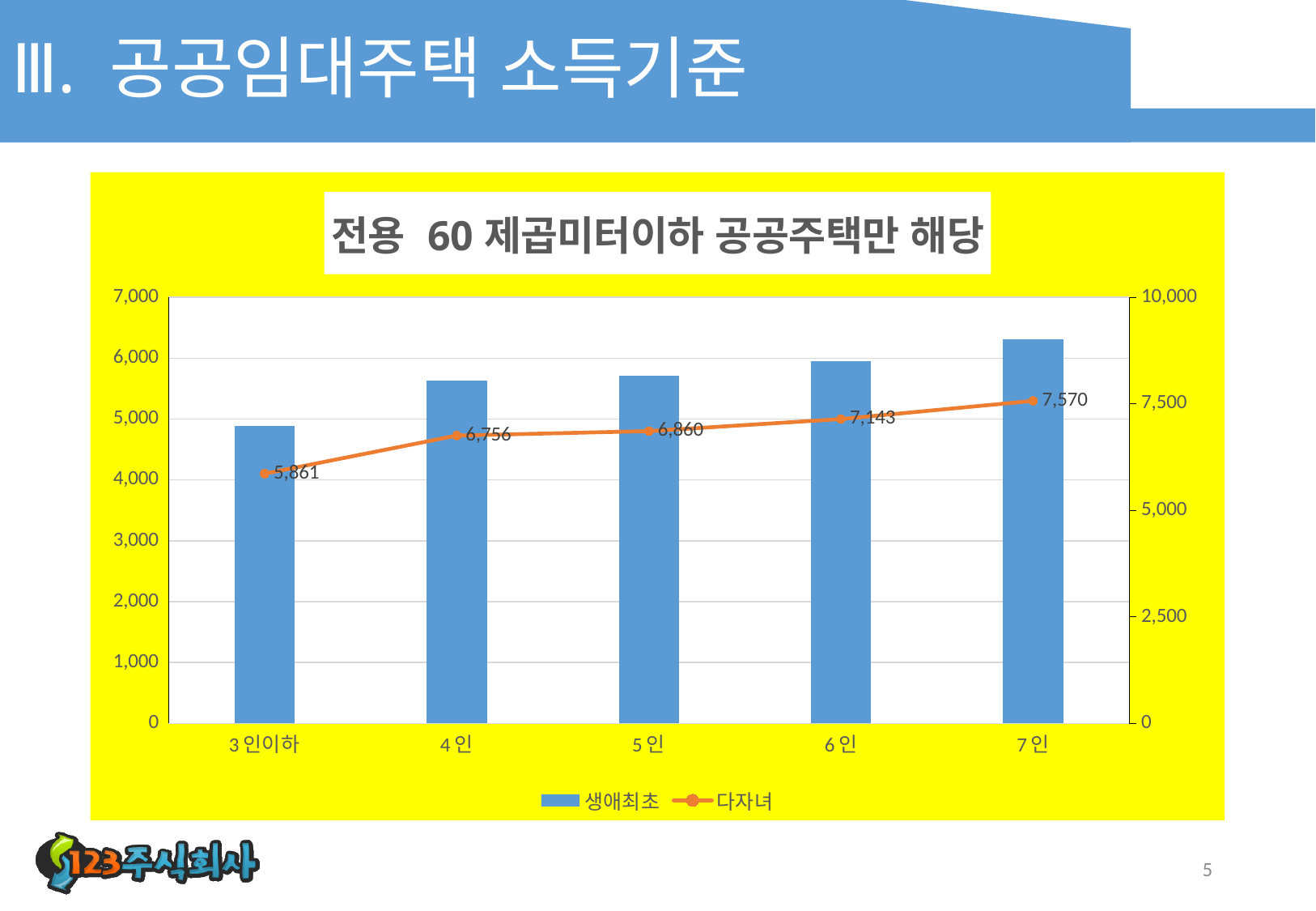
What is the 다자녀 value for 6인? 7,143 What is the difference between the 다자녀 values for 5인 and 4인? 104 Which category has the highest 다자녀 value? 7인 What is the 다자녀 value for 7인? 7,570 How many series does the legend list? 2 What is the 다자녀 value for 3인이하? 5,861 What is the difference between the 다자녀 values for 7인 and 3인이하? 1,709 How many household-size categories are shown on the x axis? 5 Is the 생애최초 value for 3인이하 greater or less than 5,000 on the left axis? less Is the 생애최초 value for 7인 greater or less than 6,000 on the left axis? greater Which category has the lowest 생애최초 bar? 3인이하 Which is larger, the 다자녀 value for 6인 or for 4인? 6인